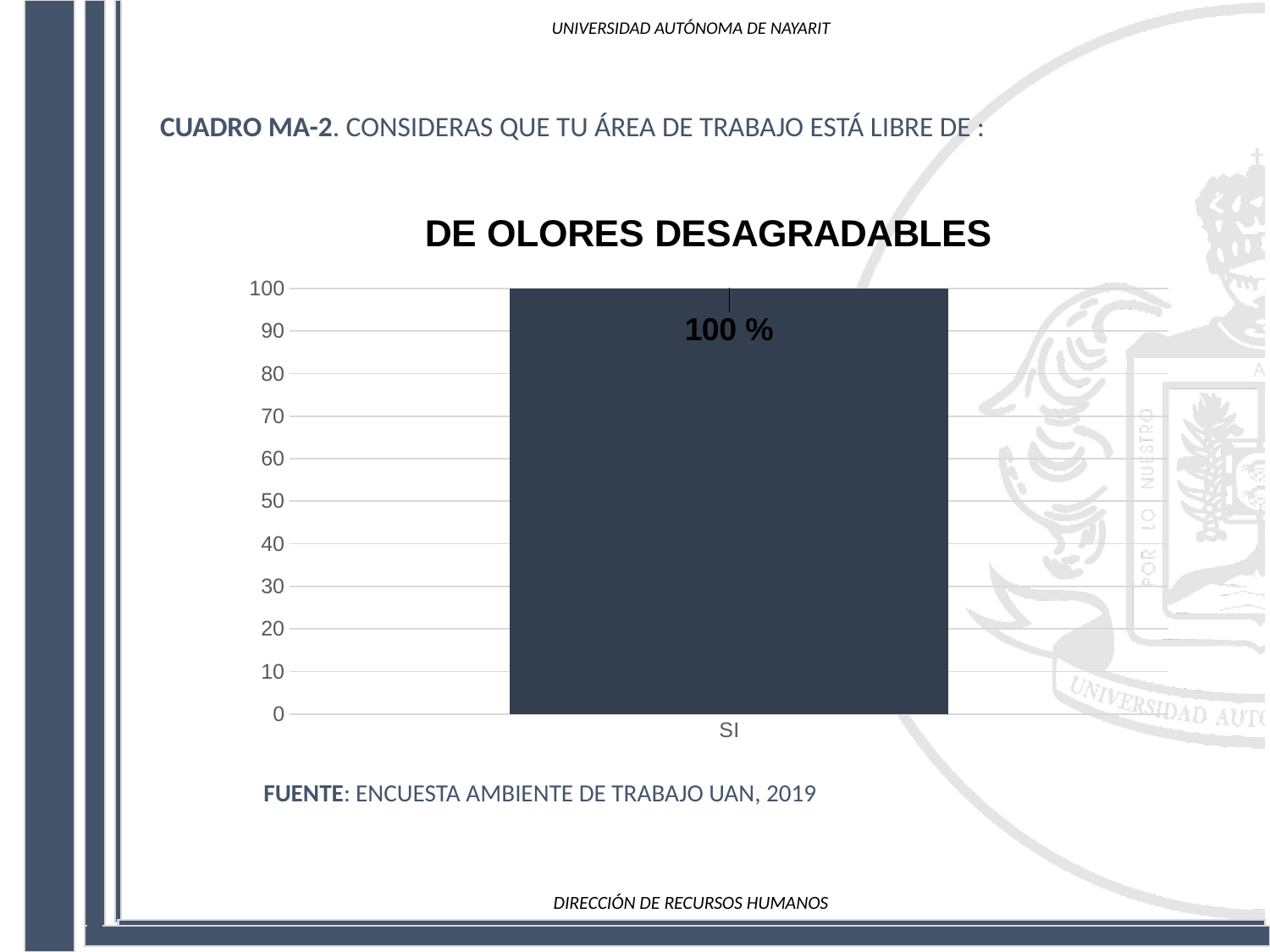
What kind of chart is shown on the slide? bar chart Is the value for SI greater or less than 50? greater How many categories are plotted on the x axis? 1 What is the label of the only category on the x axis? SI What is the title of the chart? DE OLORES DESAGRADABLES What is the value for SI? 100 % What is the maximum value shown on the y axis? 100